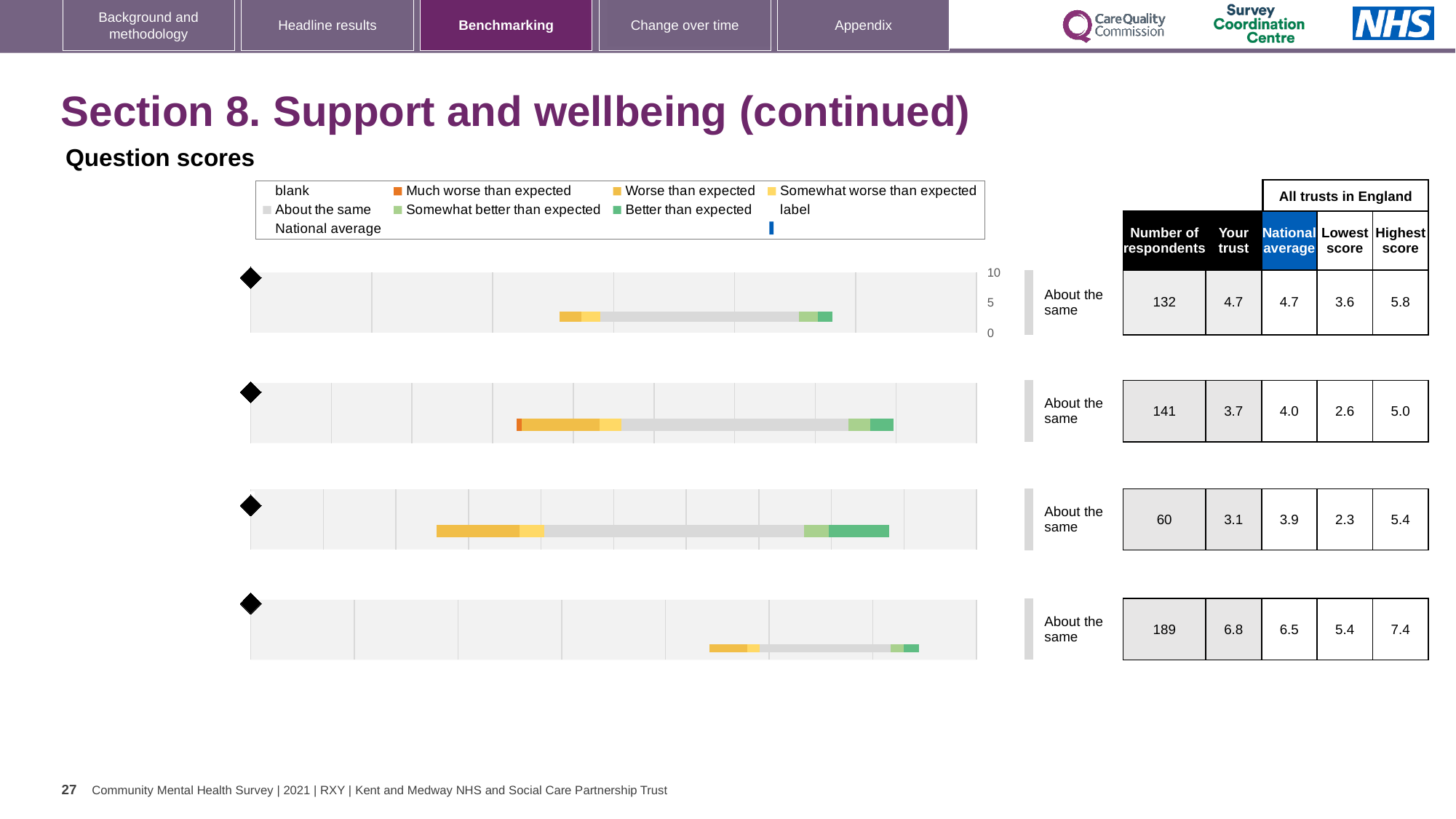
For the bottom chart, what is the highest score across all trusts in England? 7.4 For the second chart from the top, what is the difference between the highest score and the lowest score across all trusts in England? 2.4 Which chart row has the highest 'Your trust' score in the table? the bottom chart (6.8) For the top chart, what is the 'Your trust' score shown in the table? 4.7 For the third chart from the top, how many respondents are shown in the table? 60 What kind of chart is used for the four benchmarking charts on this slide? bar chart Which chart row has the lowest 'Your trust' score in the table? the third chart from the top (3.1) For the bottom chart, is the 'Your trust' score or the national average larger? Your trust (6.8) In the legend, what colour represents 'Better than expected'? green How many benchmarking charts are shown on the slide? 4 For the second chart from the top, what is the national average shown in the table? 4.0 What benchmark category is shown next to every one of the four charts? About the same